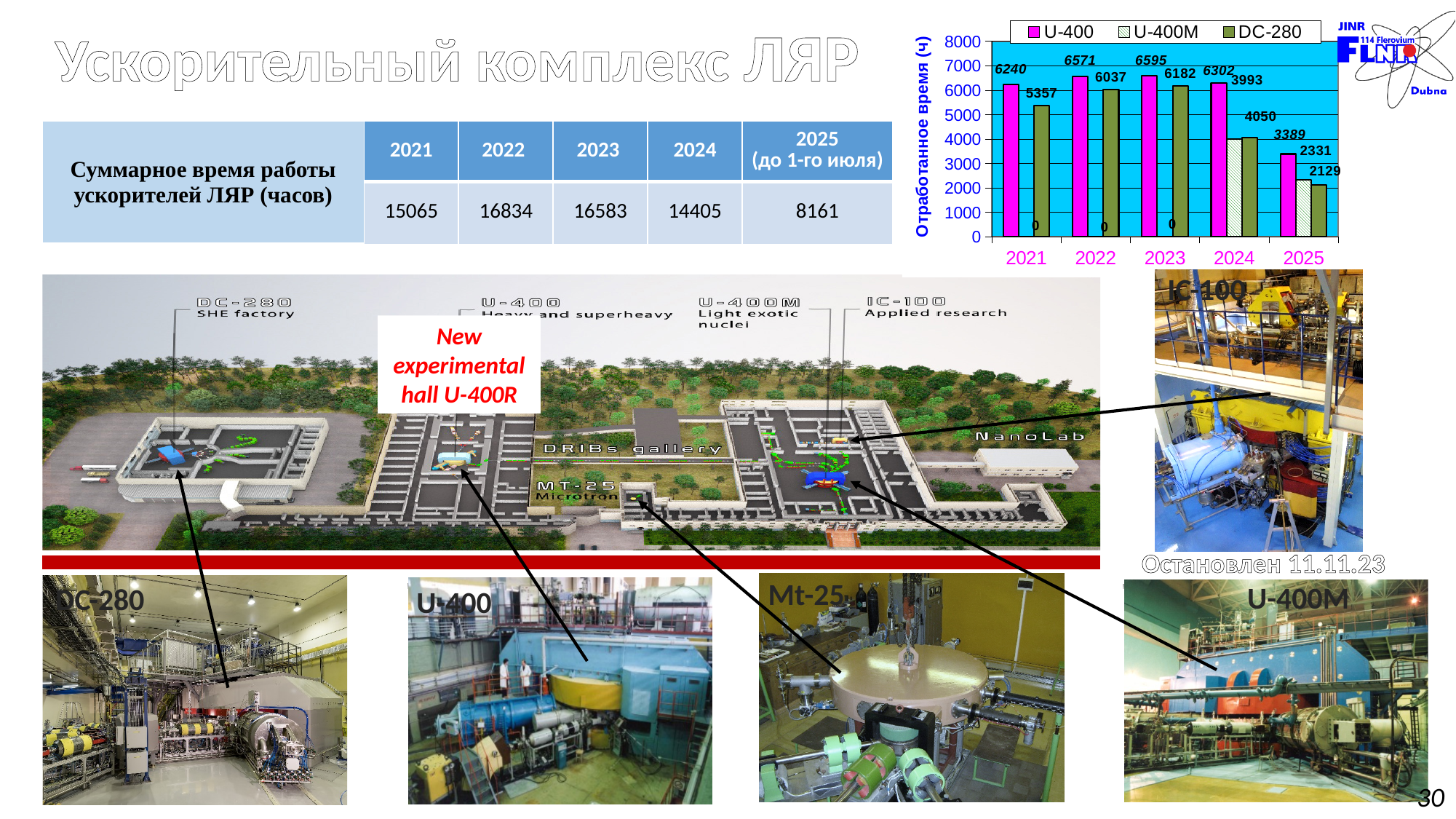
In 2024, which is larger in the bar chart: U-400M or DC-280? DC-280 How many years are shown on the x axis of the bar chart? 5 How many series does the legend of the bar chart list? 3 What is the difference between the U-400 and DC-280 values in 2022 in the bar chart? 534 What is the value for U-400M in 2024 in the bar chart? 3993 What kind of chart is shown in the top right of the slide? bar chart In which year does DC-280 have its lowest value in the bar chart? 2025 What is the value for U-400 in 2023 in the bar chart? 6595 What is the value for U-400M in 2022 in the bar chart? 0 What is the value for DC-280 in 2021 in the bar chart? 5357 In which year does U-400 have its highest value in the bar chart? 2023 What is the y-axis label of the bar chart? Отработанное время (ч)